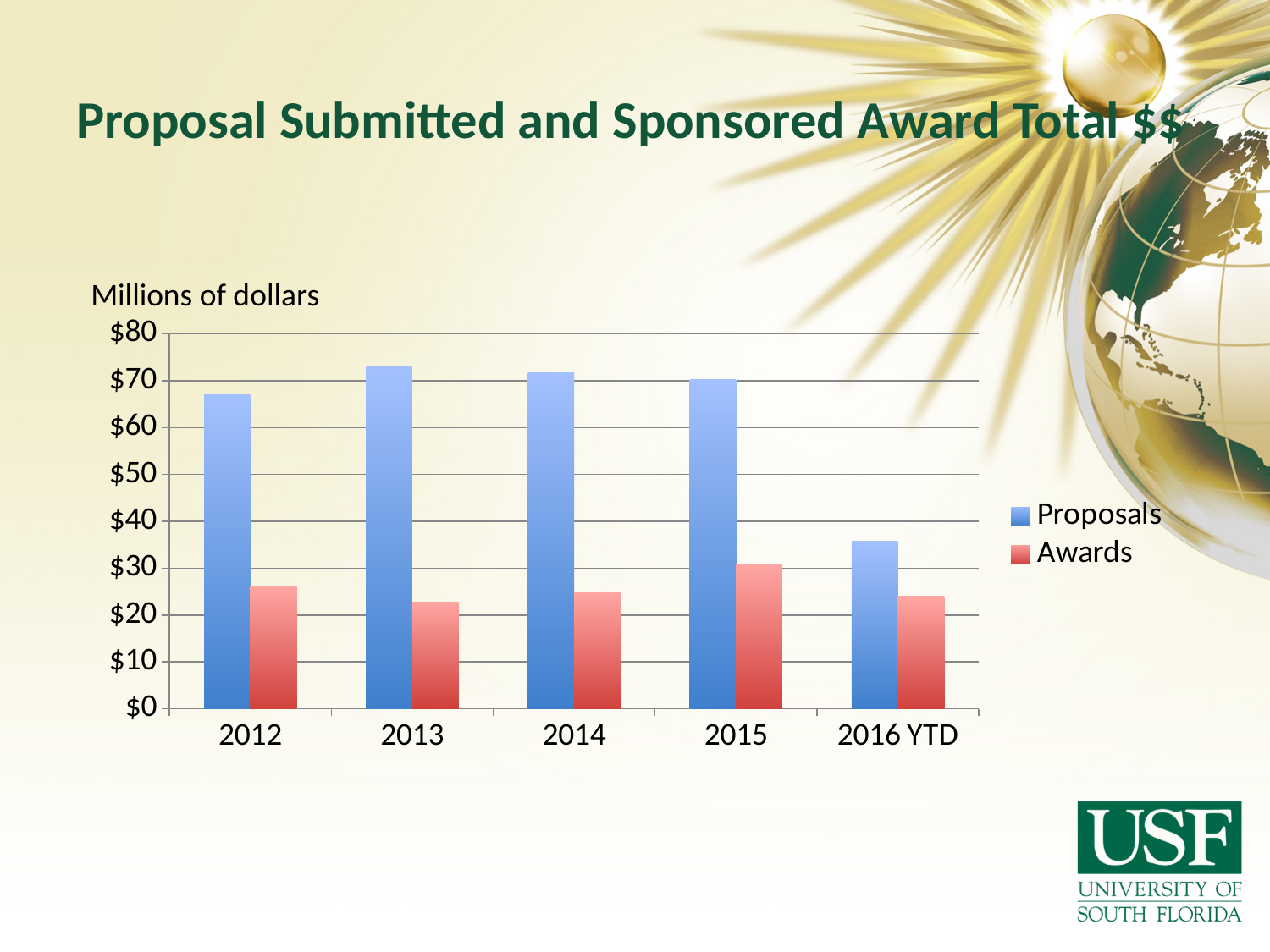
In 2014, which is larger, Proposals or Awards? Proposals What is the title of the chart on the slide? Proposal Submitted and Sponsored Award Total $$ How many year categories are shown on the x axis? 5 Which year has the lowest Proposals value? 2016 YTD Which year has the highest Awards value? 2015 Do the Proposals values rise or fall from 2015 to 2016 YTD? fall What kind of chart is shown on the slide? bar chart Is the Awards value for 2013 greater or less than $20? greater Is the Proposals value for 2012 greater or less than $60? greater What unit label is shown above the y axis of the chart? Millions of dollars Is the Proposals value for 2016 YTD greater or less than $40? less How many series does the legend list? 2